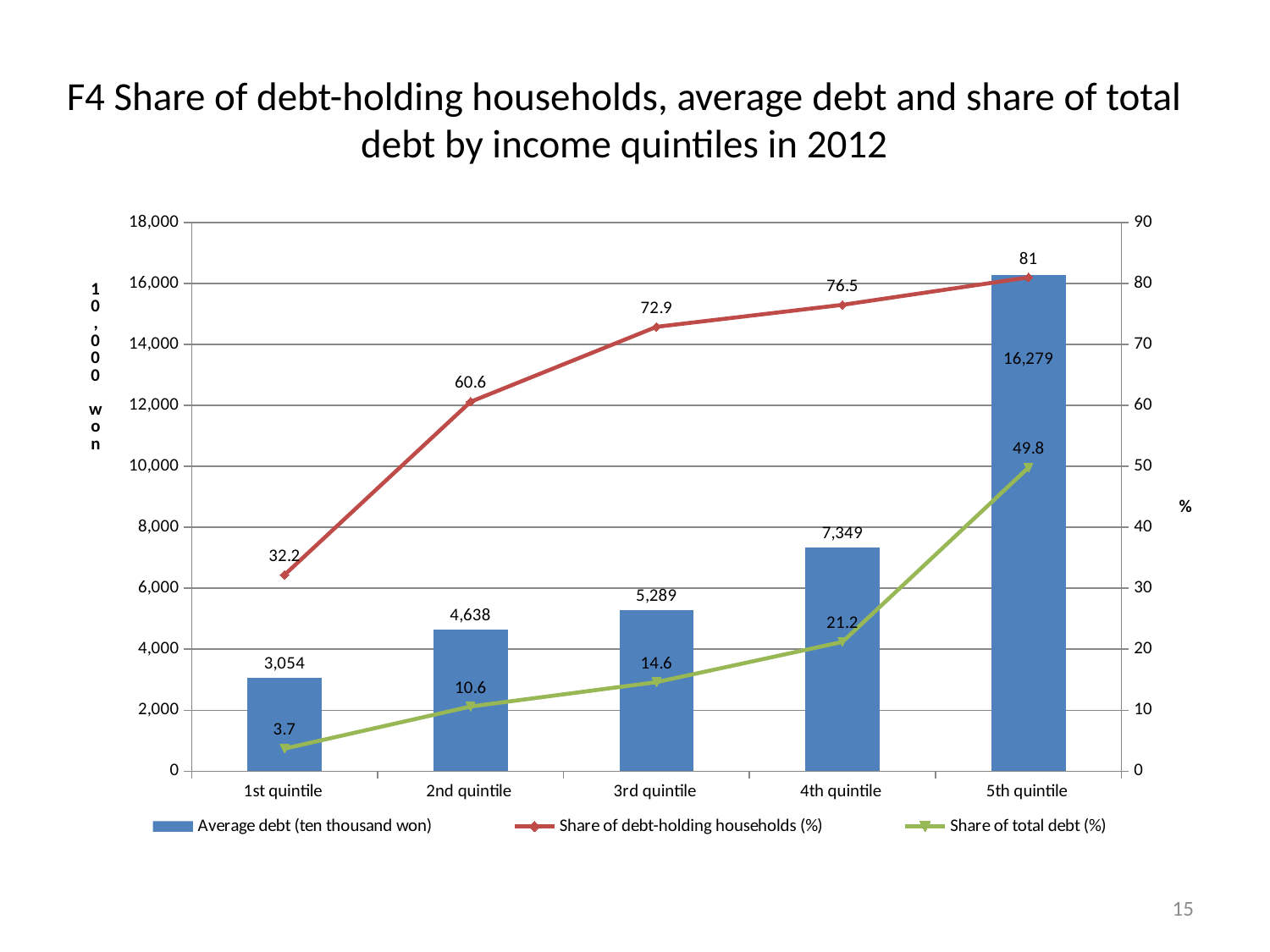
What is the average debt (ten thousand won) for the 3rd quintile? 5,289 What is the share of total debt (%) for the 4th quintile? 21.2 What is the share of debt-holding households (%) for the 2nd quintile? 60.6 Which quintile has the lowest share of total debt? 1st quintile Which quintile has the highest average debt? 5th quintile What colour are the bars for average debt? Blue Which is larger: the share of debt-holding households for the 3rd quintile or for the 2nd quintile? 3rd quintile What is the difference in average debt between the 5th quintile and the 4th quintile? 8,930 What kind of chart is this? Combined bar and line chart How many series does the legend list? 3 Does the share of total debt rise or fall from the 1st quintile to the 5th quintile? Rise How many income quintiles are shown on the x axis? 5